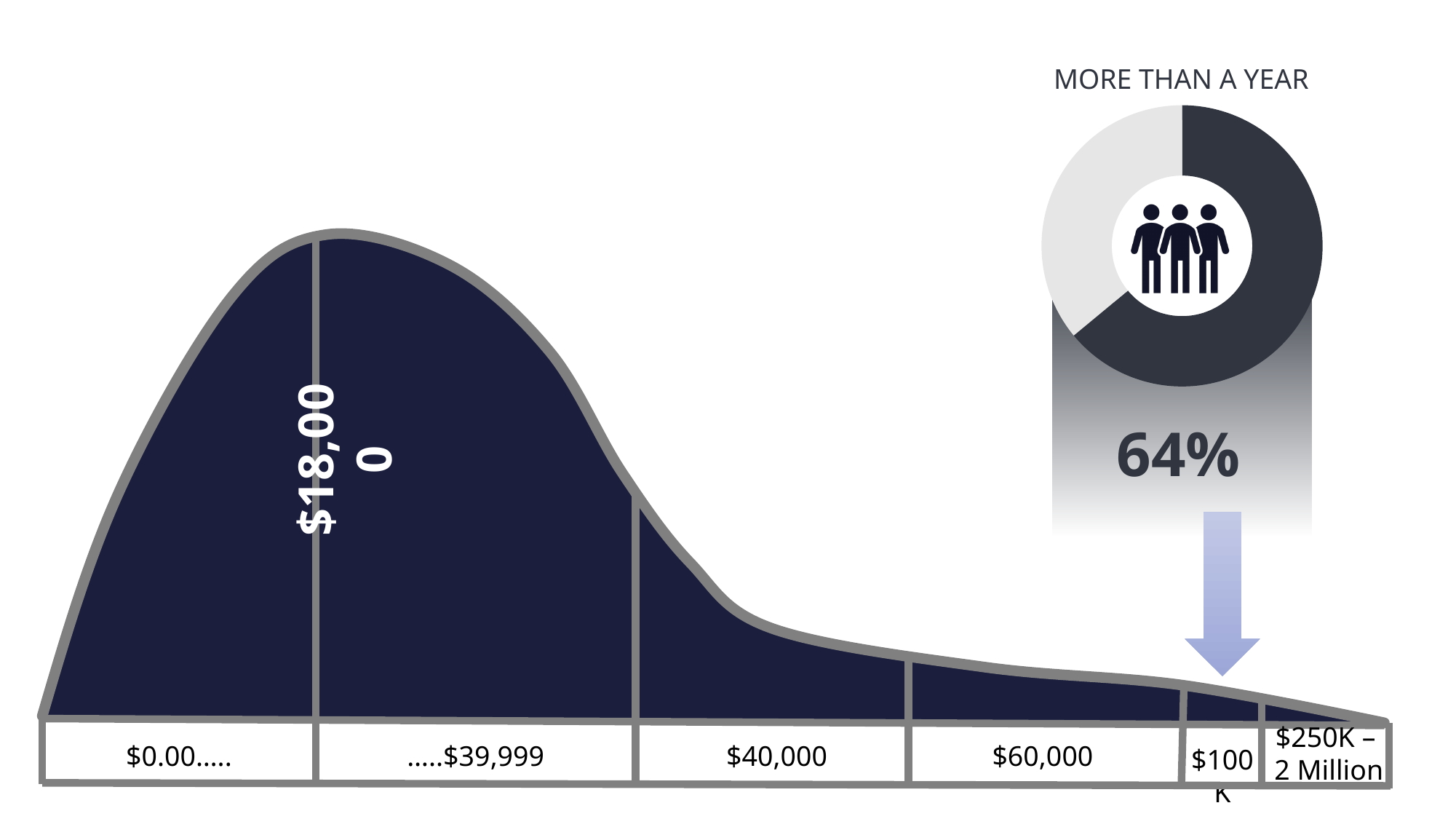
In the area chart on the left, does the curve rise or fall moving from the $40,000 range toward the $250K – 2 Million range? fall In the area chart on the left, which x-axis range has the lowest height of the curve? $250K – 2 Million What is the title of the donut chart in the top right? MORE THAN A YEAR In the area chart on the left, what value is labelled at the peak of the curve? $18,000 What is the label of the last range on the x axis of the area chart on the left? $250K – 2 Million What kind of chart is the small chart in the top right of the slide? donut chart What kind of chart is the large chart on the left of the slide? area chart In the area chart on the left, is the curve higher over the .....$39,999 range or the $100K range? .....$39,999 In the area chart on the left, is the curve higher over the $40,000 range or the $60,000 range? $40,000 In the donut chart titled MORE THAN A YEAR, what percentage is shown for the dark segment? 64% How many labelled ranges are shown along the x axis of the area chart on the left? 6